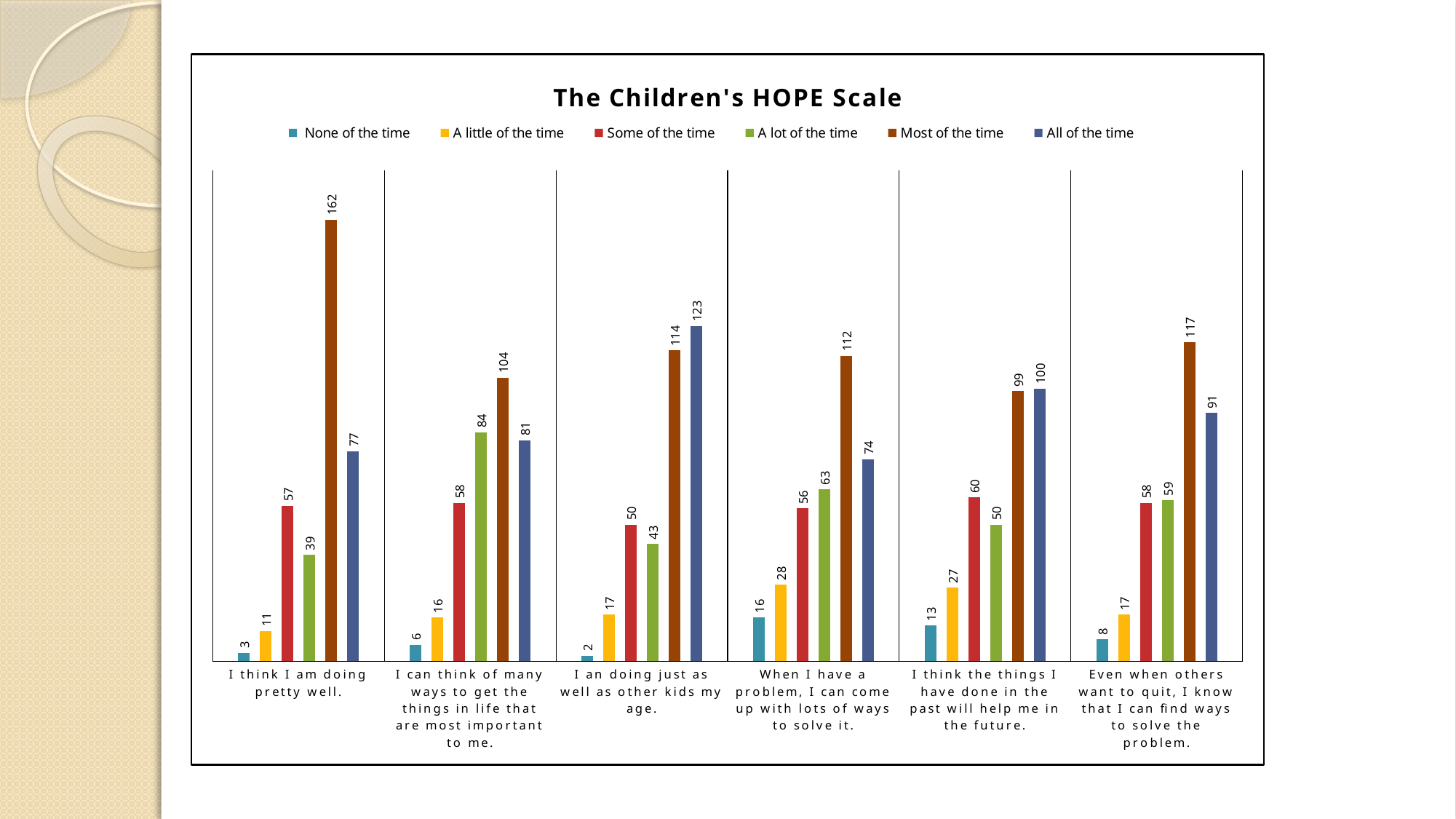
What is the value for "Most of the time" for the statement "I think I am doing pretty well."? 162 What is the title of the chart? The Children's HOPE Scale Which statement has the highest value for "Most of the time"? I think I am doing pretty well. What is the value for "None of the time" for the statement "When I have a problem, I can come up with lots of ways to solve it."? 16 What type of chart is shown on the slide? bar chart What is the value for "All of the time" for the statement "I an doing just as well as other kids my age."? 123 What is the value for "A lot of the time" for the statement "I can think of many ways to get the things in life that are most important to me."? 84 Which statement has the lowest value for "None of the time"? I an doing just as well as other kids my age. For the statement "Even when others want to quit, I know that I can find ways to solve the problem.", which is larger: "Most of the time" or "All of the time"? Most of the time How many categories (statements) are shown along the x axis? 6 How many series does the legend list? 6 What is the difference between the "Most of the time" and "All of the time" values for the statement "I think I am doing pretty well."? 85